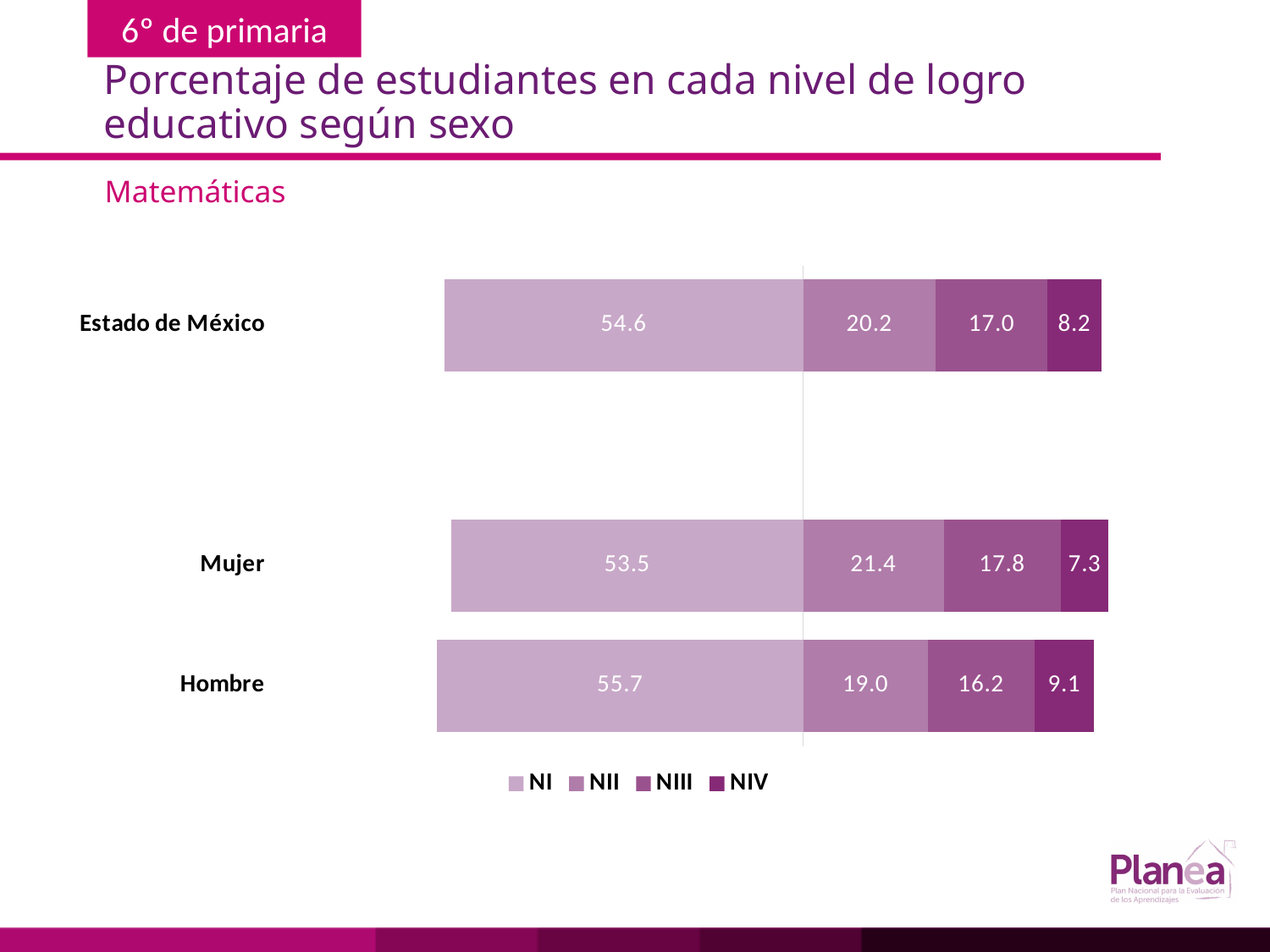
Which category has the highest NI value? Hombre What is the NI value for Hombre? 55.7 Which category has the lowest NIV value? Mujer What is the difference between the NII values for Mujer and Hombre? 2.4 What kind of chart is shown on the slide? Stacked bar chart What is the total of the stacked bar for Hombre? 100.0 Which is larger, the NIII value for Mujer or for Estado de México? Mujer How many series does the legend list? 4 How many categories are shown on the chart? 3 What is the NIII value for Hombre? 16.2 What is the NIV value for Mujer? 7.3 What is the NII value for Estado de México? 20.2